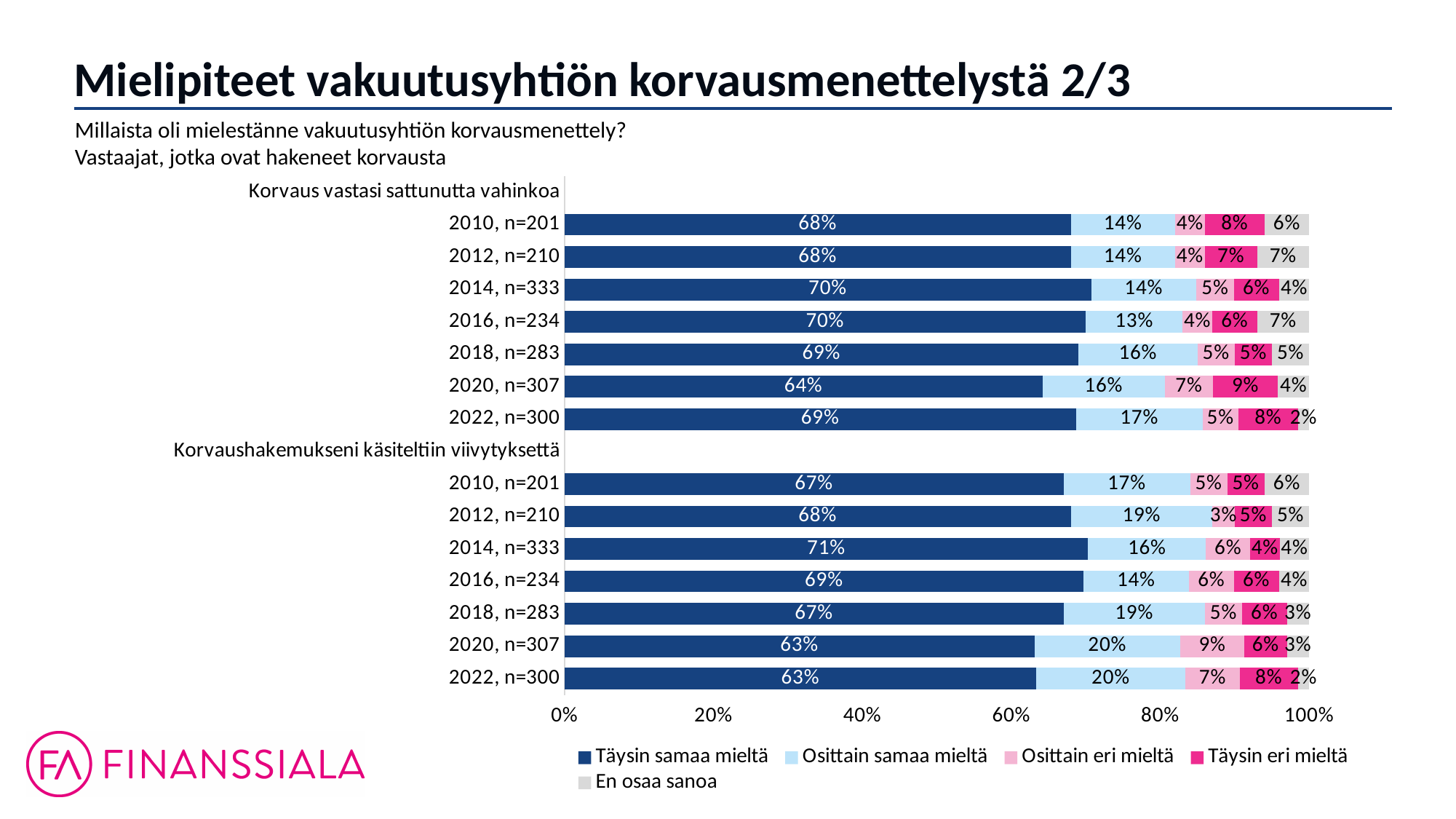
Which legend entry is shown in grey? En osaa sanoa What is the difference between the "Täysin samaa mieltä" shares for 2014, n=333 and 2020, n=307 in the "Korvaus vastasi sattunutta vahinkoa" group? 6 percentage points What kind of chart is shown on the slide? Stacked bar chart How many bars are plotted on the chart in total? 14 What percentage of respondents in 2022 (n=300) were "Täysin samaa mieltä" that "Korvaus vastasi sattunutta vahinkoa"? 69% What is the "Täysin eri mieltä" share for 2020, n=307 in the "Korvaus vastasi sattunutta vahinkoa" group? 9% In the "Korvaus vastasi sattunutta vahinkoa" group, which year has the lowest "Täysin samaa mieltä" share? 2020, n=307 In the "Korvaushakemukseni käsiteltiin viivytyksettä" group, what is the "Osittain samaa mieltä" share for 2020, n=307? 20% In the "Korvaushakemukseni käsiteltiin viivytyksettä" group, which year has the highest "Täysin samaa mieltä" share? 2014, n=333 How many series does the legend list? 5 In the "Korvaushakemukseni käsiteltiin viivytyksettä" group, is the "Osittain samaa mieltä" share larger for 2012, n=210 or for 2016, n=234? 2012, n=210 What is the combined share of "Täysin samaa mieltä" and "Osittain samaa mieltä" for 2022, n=300 in the "Korvaushakemukseni käsiteltiin viivytyksettä" group? 83%